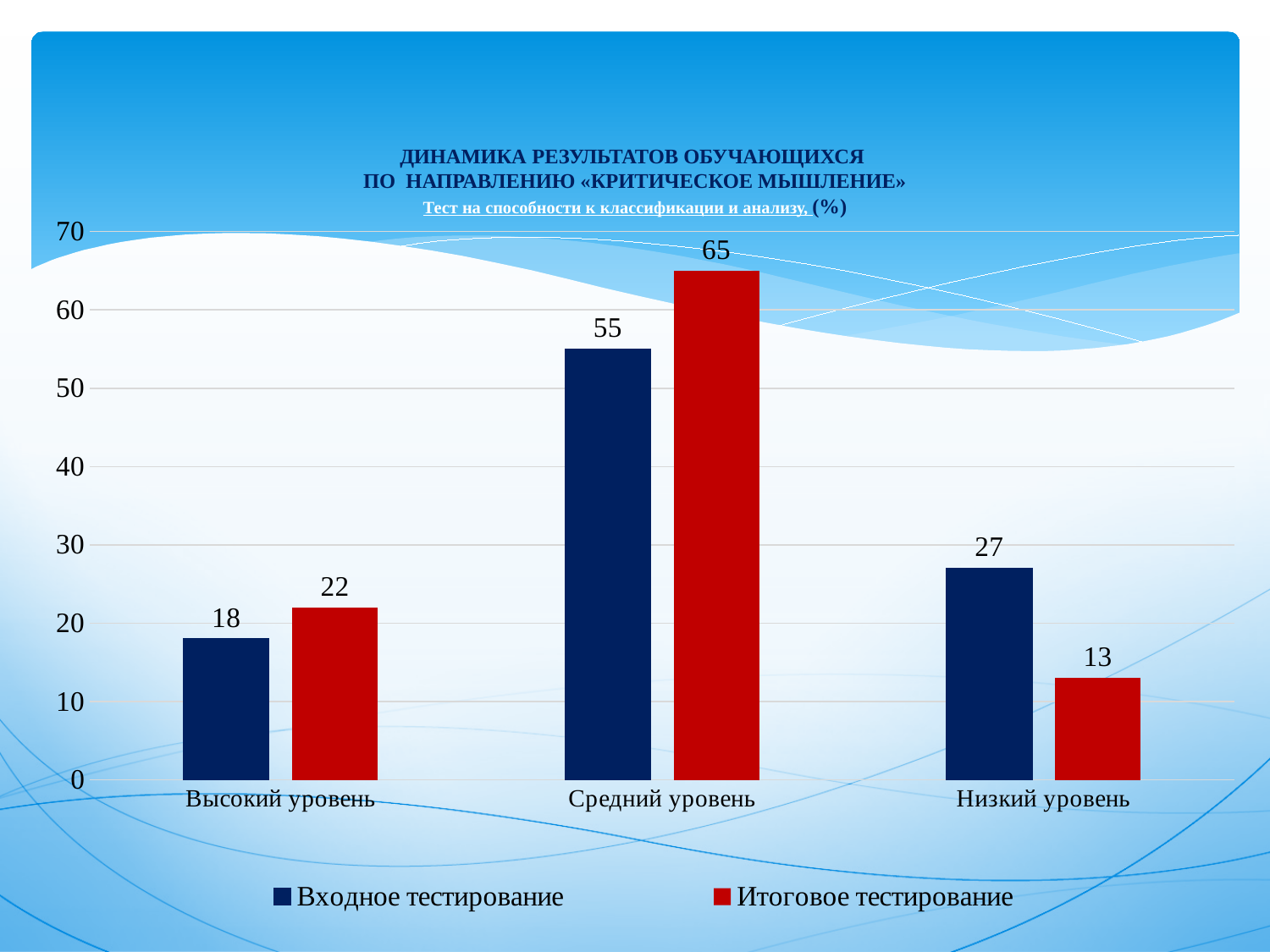
Which is larger at Высокий уровень: Входное тестирование or Итоговое тестирование? Итоговое тестирование How many categories are shown on the x axis? 3 What kind of chart is shown on the slide? Bar chart How many series does the legend list? 2 What is the value for Итоговое тестирование at Высокий уровень? 22 Which colour represents Итоговое тестирование in the legend? Red Which category has the highest value for Итоговое тестирование? Средний уровень What is the value for Входное тестирование at Средний уровень? 55 Which category has the lowest value for Входное тестирование? Высокий уровень What is the difference between Итоговое тестирование and Входное тестирование at Средний уровень? 10 What is the value for Итоговое тестирование at Низкий уровень? 13 What is the difference between Входное тестирование and Итоговое тестирование at Низкий уровень? 14